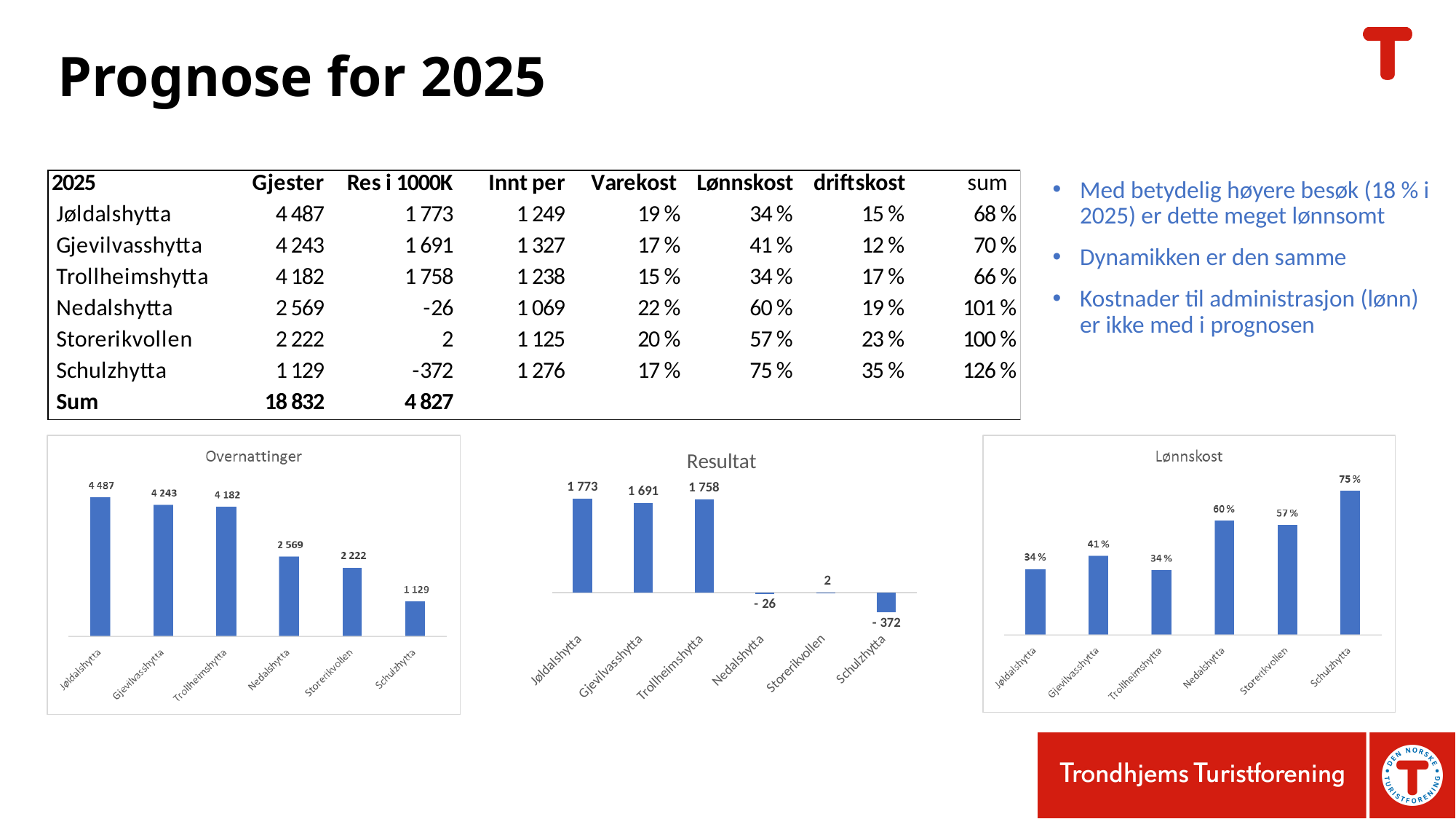
In the 'Lønnskost' chart, what is the value for Nedalshytta? 60 % In the 'Resultat' chart, which category has the highest value? Jøldalshytta In the 'Overnattinger' chart, what is the value for Jøldalshytta? 4 487 In the 'Overnattinger' chart, what is the difference between Nedalshytta and Storerikvollen? 347 In the 'Overnattinger' chart, which category has the lowest value? Schulzhytta In the 'Resultat' chart, which is larger: Gjevilvasshytta or Trollheimshytta? Trollheimshytta What type of chart is the 'Lønnskost' chart? Bar chart In the 'Lønnskost' chart, what is the difference between Schulzhytta and Jøldalshytta? 41 % In the 'Lønnskost' chart, which category has the highest value? Schulzhytta In the 'Resultat' chart, what is the value for Schulzhytta? - 372 In the 'Resultat' chart, what is the value for Storerikvollen? 2 In the 'Overnattinger' chart, how many categories are shown? 6